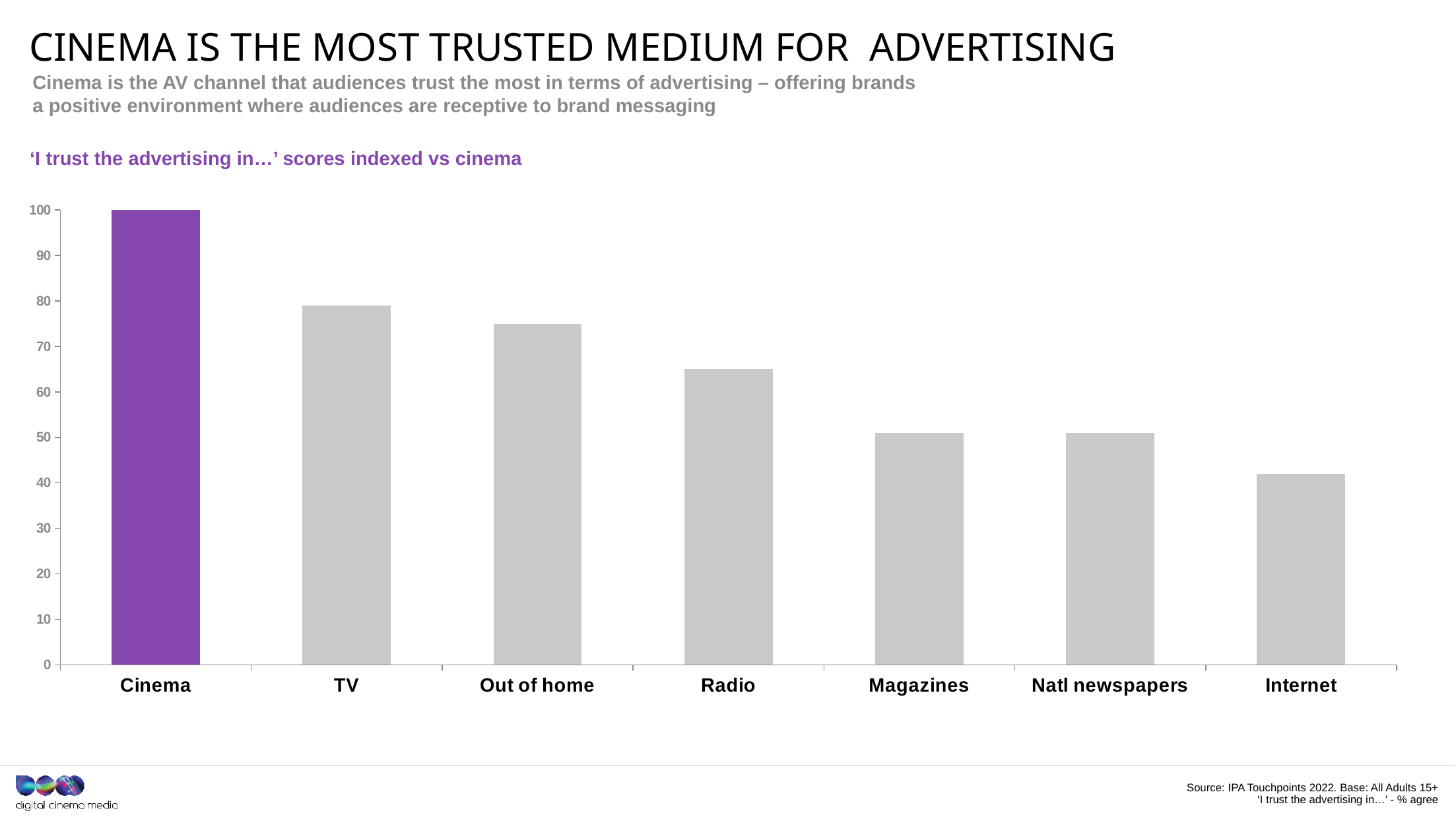
What is the value for Cinema? 100 Which is larger, the value for TV or the value for Radio? TV Which category has the highest value? Cinema Which is larger, the value for Magazines or the value for Internet? Magazines Is the value for TV greater or less than 70? greater Is the value for Out of home greater or less than 80? less Is the value for Radio greater or less than 60? greater What kind of chart is shown? Bar chart Which category has the lowest value? Internet Which bar is coloured purple rather than grey? Cinema How many categories are shown on the x axis? 7